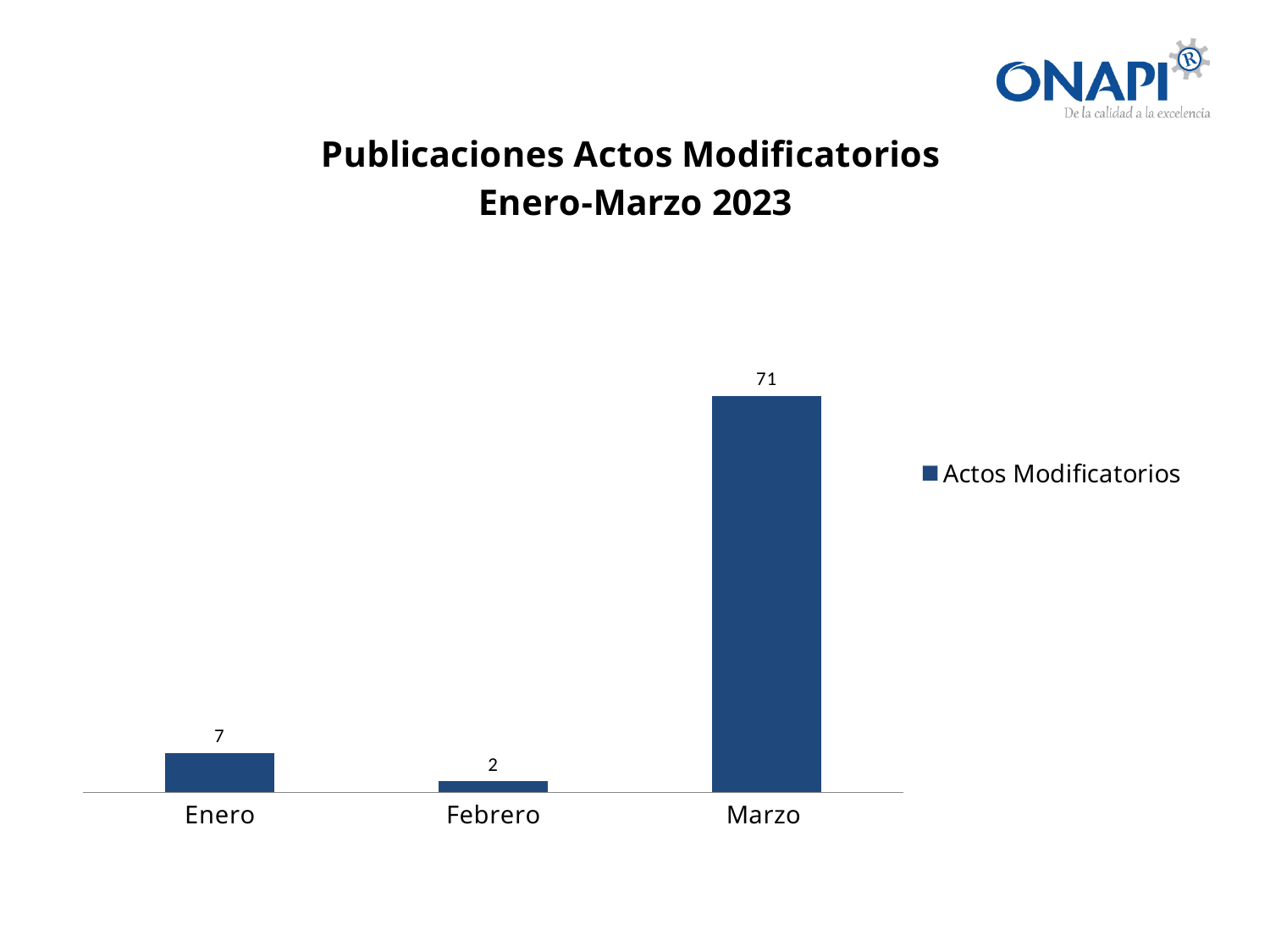
How many months are shown on the x axis? 3 What is the difference between the values for Enero and Febrero? 5 Which month has the lowest value? Febrero Which month has the highest value? Marzo What is the value for Enero? 7 What is the value for Febrero? 2 What is the value for Marzo? 71 What kind of chart is shown on the slide? Bar chart What is the title of the chart? Publicaciones Actos Modificatorios Enero-Marzo 2023 Which is larger, the value for Enero or the value for Febrero? Enero What is the difference between the values for Marzo and Enero? 64 How many series does the legend list? 1